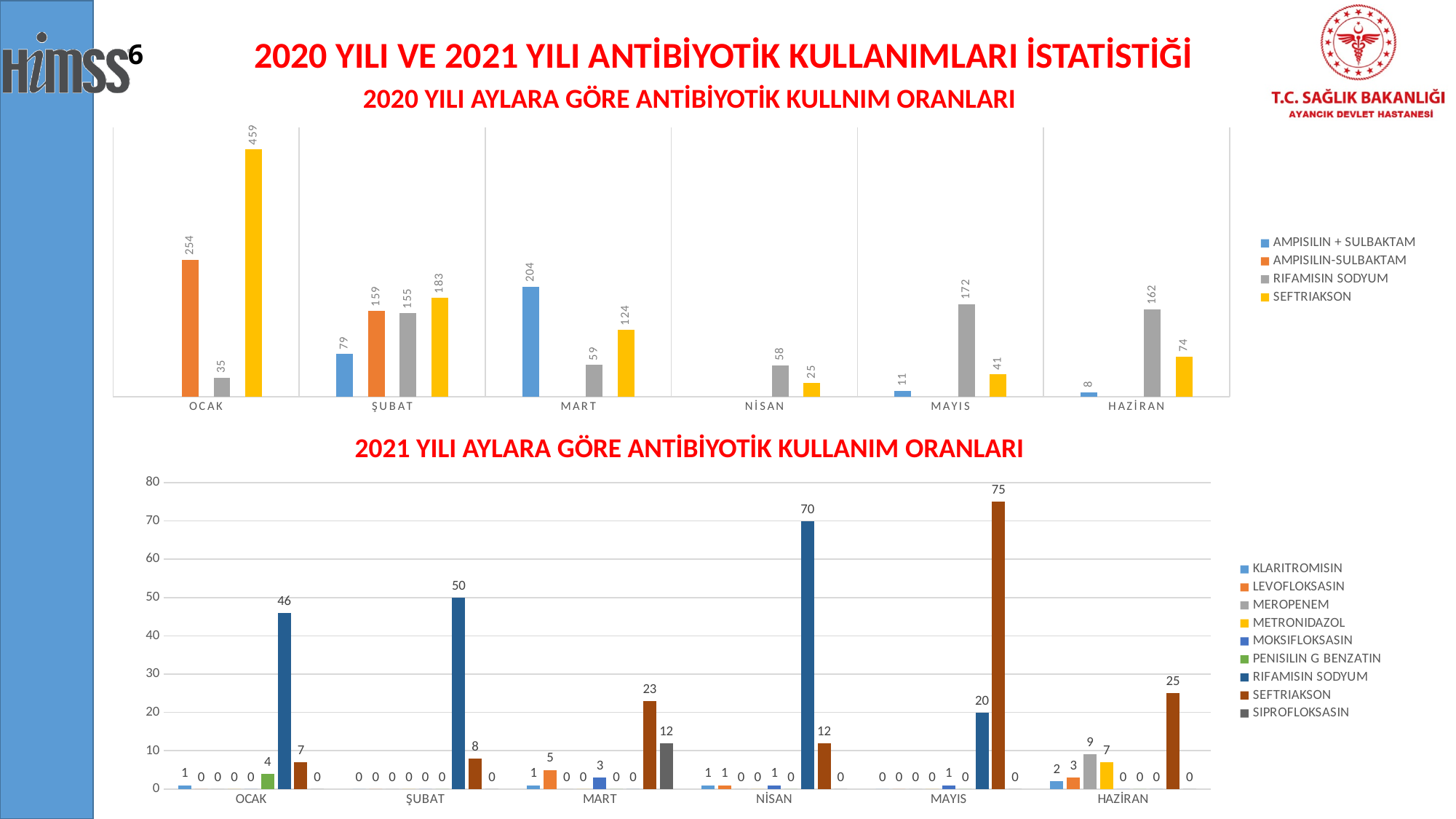
In the 2021 chart, what is the value of SEFTRIAKSON in MAYIS? 75 In the 2021 chart, what is the difference between the SEFTRIAKSON values in MAYIS and HAZİRAN? 50 In the 2020 chart, what is the value of SEFTRIAKSON in OCAK? 459 In the 2021 chart, what is the value of RIFAMISIN SODYUM in NİSAN? 70 In the 2020 chart, what is the difference between the AMPISILIN-SULBAKTAM value in OCAK and in ŞUBAT? 95 How many series does the legend of the 2020 chart list? 4 How many series does the legend of the 2021 chart list? 9 In the 2020 chart, what is the value of RIFAMISIN SODYUM in MAYIS? 172 In the 2021 chart, which month has the lowest RIFAMISIN SODYUM value among OCAK, ŞUBAT, NİSAN and MAYIS? MAYIS In the 2020 chart, which month has the highest SEFTRIAKSON value? OCAK What type of chart is the 2021 chart? Bar chart In the 2020 chart, which is larger in MART: AMPISILIN + SULBAKTAM or SEFTRIAKSON? AMPISILIN + SULBAKTAM